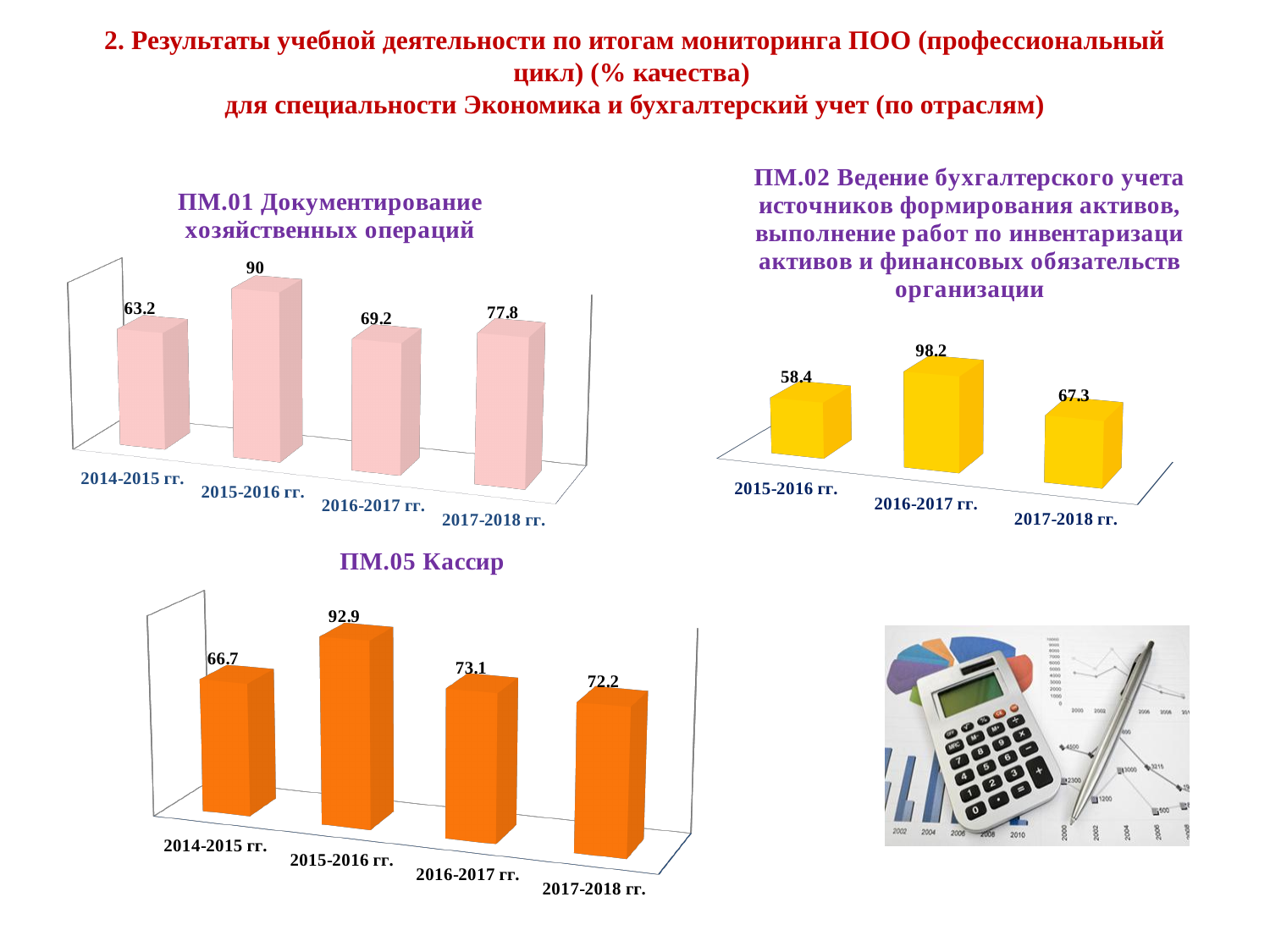
How many bars are in the ПМ.01 Документирование хозяйственных операций chart? 4 In the ПМ.01 Документирование хозяйственных операций chart, which year has the lowest value? 2014-2015 гг. In the ПМ.02 chart (top right), which year has the highest value? 2016-2017 гг. In the ПМ.01 Документирование хозяйственных операций chart, what is the difference between the values for 2017-2018 гг. and 2016-2017 гг.? 8.6 In the ПМ.02 chart (top right), what is the difference between the values for 2017-2018 гг. and 2015-2016 гг.? 8.9 What type of chart is the ПМ.05 Кассир chart? Bar chart In the ПМ.02 chart (top right), what is the value for 2016-2017 гг.? 98.2 In the ПМ.05 Кассир chart, what is the value for 2014-2015 гг.? 66.7 In the ПМ.05 Кассир chart, what is the difference between the values for 2015-2016 гг. and 2014-2015 гг.? 26.2 In the ПМ.05 Кассир chart, which is larger, the value for 2016-2017 гг. or 2017-2018 гг.? 2016-2017 гг. How many bars are in the ПМ.02 chart (top right)? 3 In the ПМ.01 Документирование хозяйственных операций chart, what is the value for 2015-2016 гг.? 90